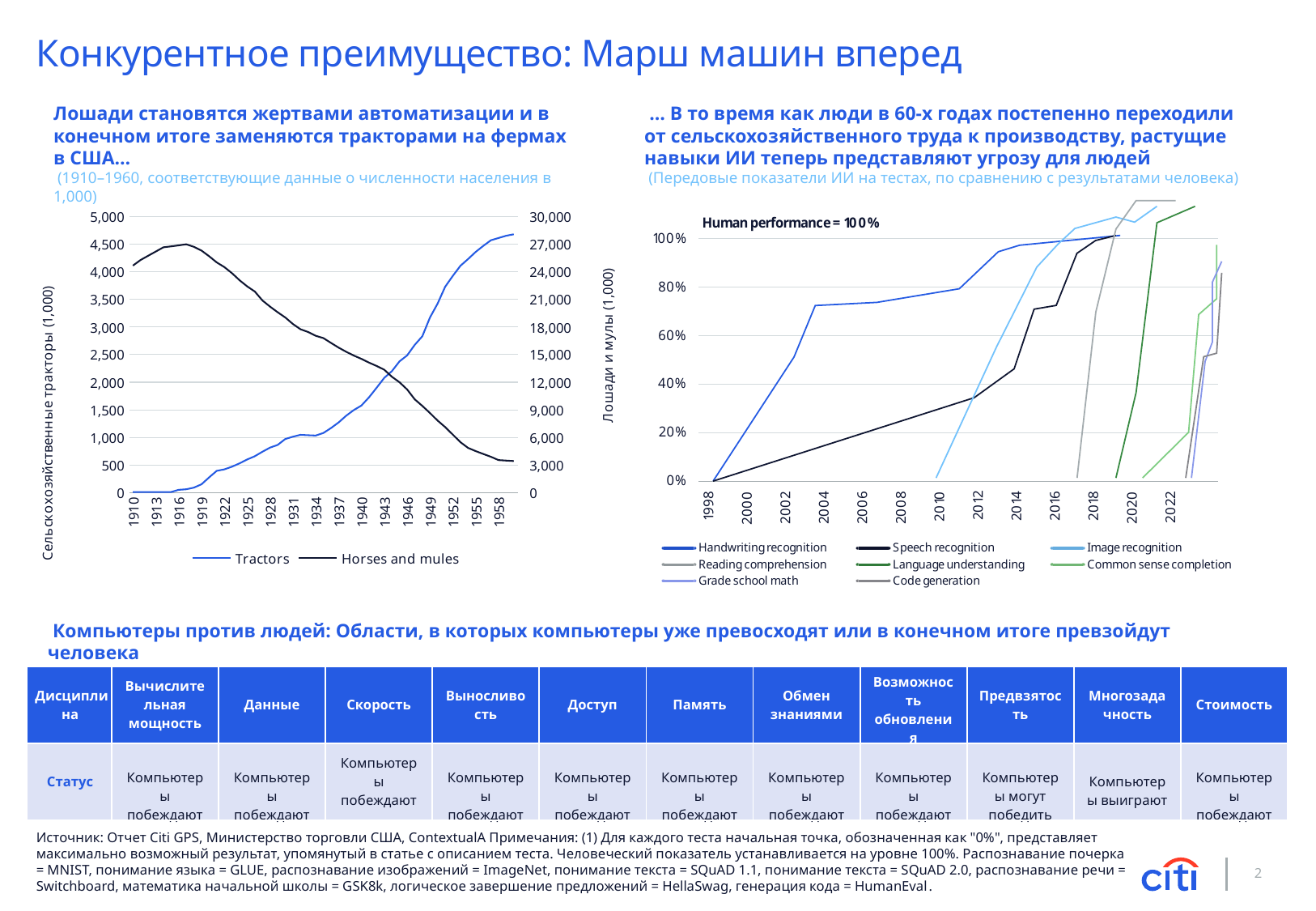
In the right chart, what level is labelled as human performance? 100% How many series does the legend of the left chart list? 2 How many series does the legend of the right chart list? 8 What kind of chart is the right chart showing AI benchmark performance? Line chart In the right chart, is the value for Handwriting recognition in 2004 greater or less than 60%? greater In the left chart, is the value for Tractors in 1940 greater or less than 1,500? greater In the right chart, which is larger in 2010: Handwriting recognition or Speech recognition? Handwriting recognition In the left chart, does the Tractors series rise or fall from 1910 to 1958? Rise In the left chart, does the Horses and mules series rise or fall from 1919 to 1958? Fall In the left chart, is the value for Tractors in 1925 greater or less than 1,000? less What kind of chart is the left chart showing tractors and horses and mules? Line chart